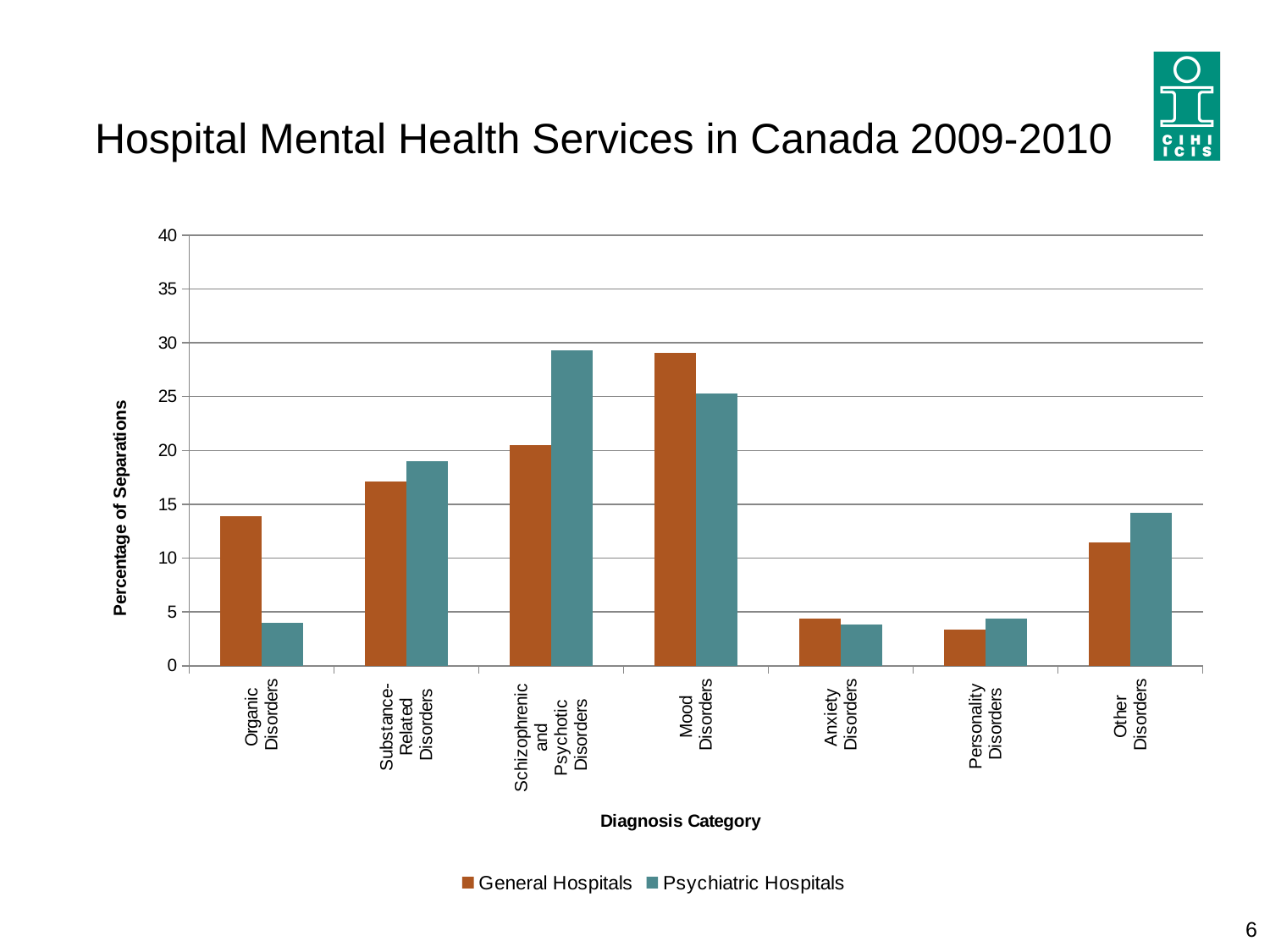
For Organic Disorders, which is larger: General Hospitals or Psychiatric Hospitals? General Hospitals What is the label of the y axis? Percentage of Separations What kind of chart is shown on the slide? bar chart How many diagnosis categories are shown on the x axis? 7 Is the value for General Hospitals in Anxiety Disorders greater or less than 5? less Which diagnosis category has the highest percentage of separations for General Hospitals? Mood Disorders Which diagnosis category has the highest percentage of separations for Psychiatric Hospitals? Schizophrenic and Psychotic Disorders Which diagnosis category has the lowest percentage of separations for General Hospitals? Personality Disorders For Schizophrenic and Psychotic Disorders, which is larger: General Hospitals or Psychiatric Hospitals? Psychiatric Hospitals Is the value for General Hospitals in Mood Disorders greater or less than 25? greater How many series does the legend list? 2 Is the value for Psychiatric Hospitals in Other Disorders greater or less than 10? greater